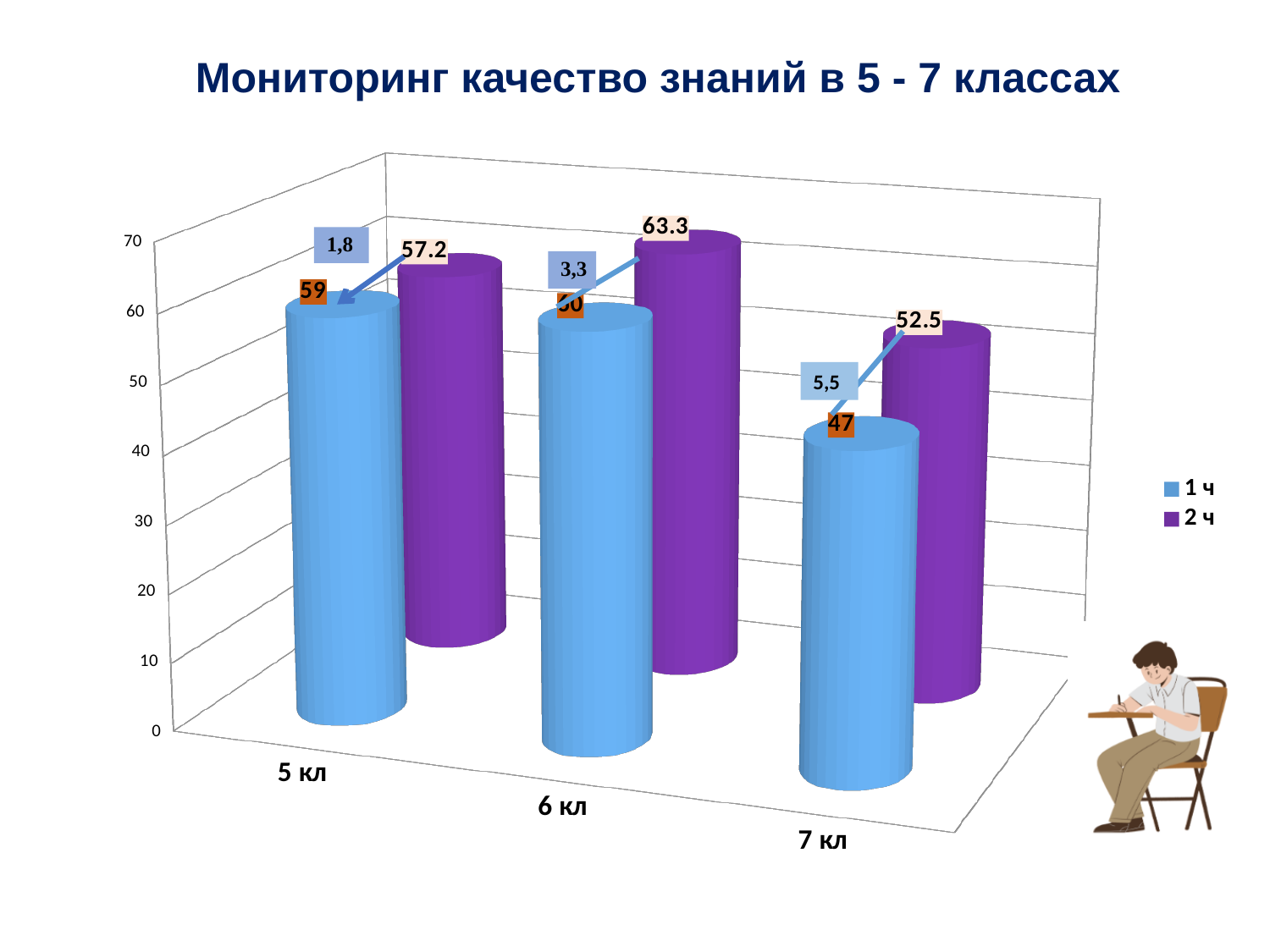
What is the difference between the 2 ч and 1 ч values for 7 кл? 5,5 How many classes are shown on the x axis? 3 For 7 кл, which is larger: 1 ч or 2 ч? 2 ч What is the value for 1 ч in 5 кл? 59 What is the value for 1 ч in 7 кл? 47 What is the value for 2 ч in 7 кл? 52.5 How many series does the legend list? 2 Which class has the lowest value for 1 ч? 7 кл What is the value for 2 ч in 6 кл? 63.3 What is the value for 2 ч in 5 кл? 57.2 Which class has the highest value for 2 ч? 6 кл Is the value for 1 ч in 6 кл greater or less than 50? greater